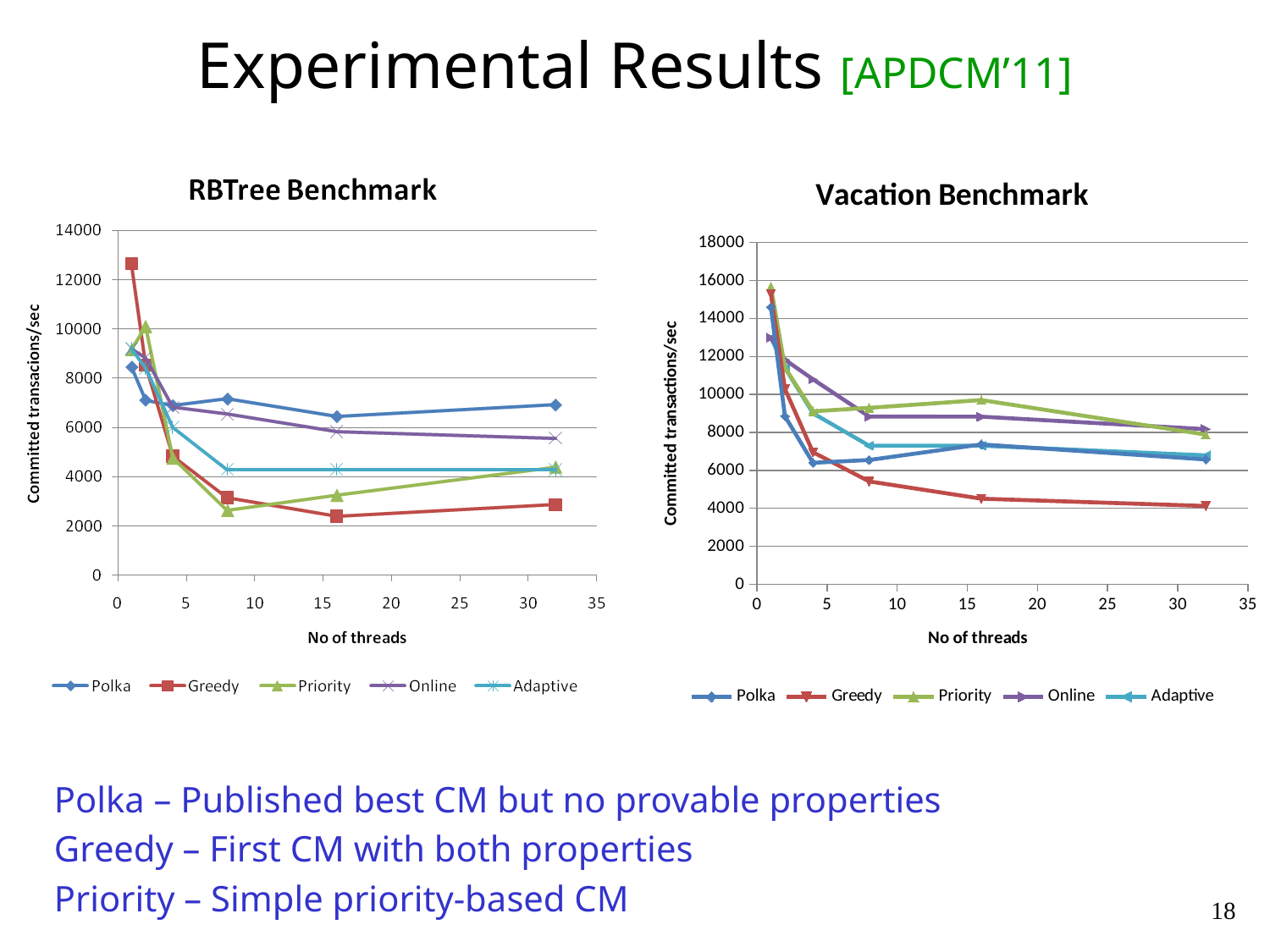
What is the x-axis label of the Vacation Benchmark chart? No of threads In the Vacation Benchmark chart, is the value for Greedy at 32 threads greater or less than 6000? less In the RBTree Benchmark chart, which series has the highest value at 32 threads? Polka In the RBTree Benchmark chart, is the value for Greedy at 16 threads greater or less than 4000? less In the Vacation Benchmark chart, is the value for Priority at 1 thread greater or less than 14000? greater In the Vacation Benchmark chart, which series has the lowest value at 32 threads? Greedy In the RBTree Benchmark chart, which is larger at 16 threads, Polka or Greedy? Polka How many series does the legend of the Vacation Benchmark chart list? 5 In the Vacation Benchmark chart, does the Greedy series rise or fall as the number of threads increases from 1 to 32? fall What kind of chart is the RBTree Benchmark chart? line chart In the RBTree Benchmark chart, which series has the lowest value at 32 threads? Greedy